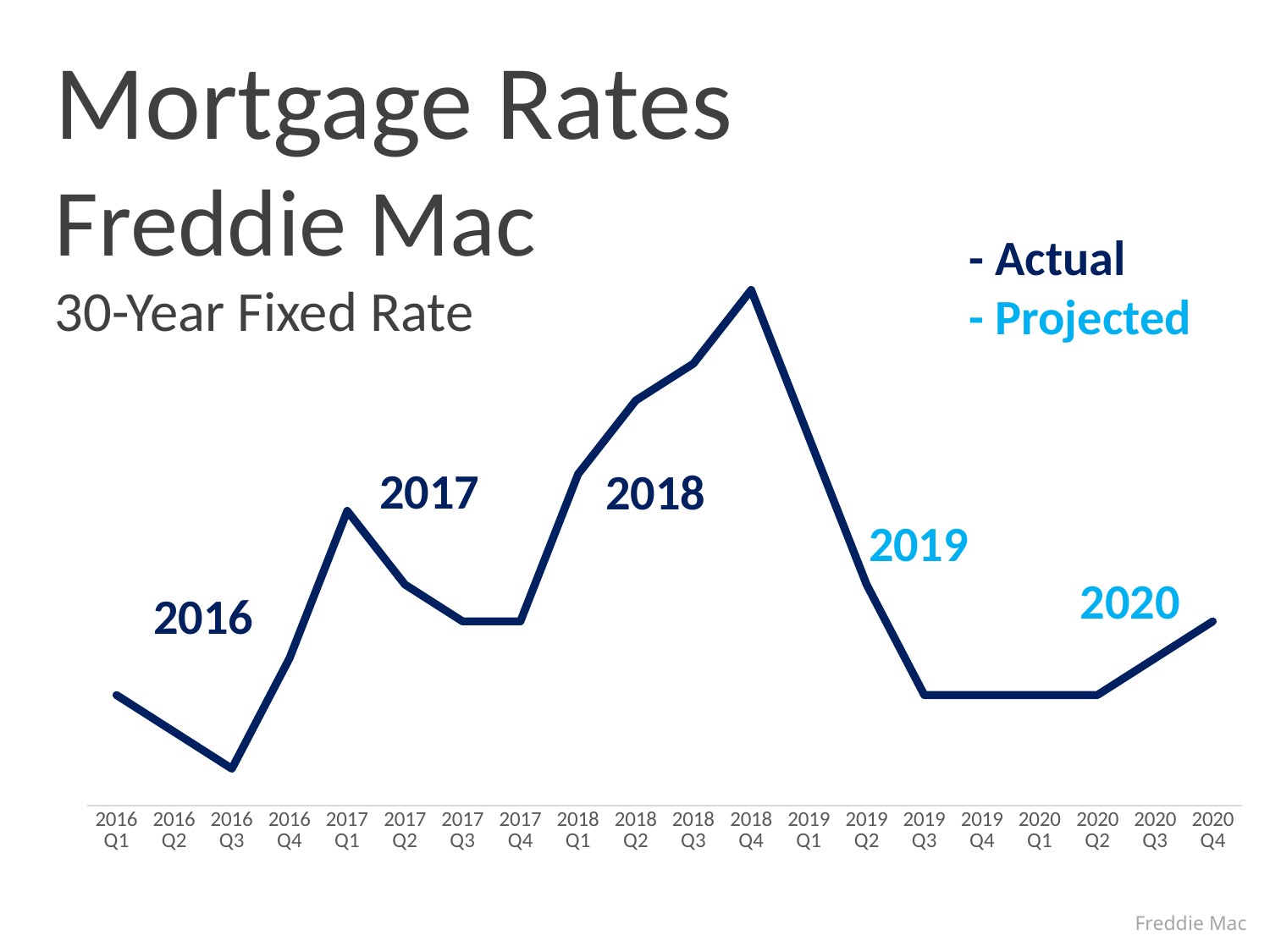
Which is higher, the rate in 2018 Q1 or the rate in 2020 Q4? 2018 Q1 Which years on the chart are labelled in the light blue 'Projected' colour? 2019 and 2020 What kind of chart is shown on the slide? line chart Does the rate rise or fall from 2018 Q1 to 2018 Q4? rise In which quarter does the mortgage rate reach its lowest point? 2016 Q3 Which is higher, the rate in 2016 Q3 or the rate in 2018 Q4? 2018 Q4 Which is higher, the rate in 2017 Q1 or the rate in 2019 Q3? 2017 Q1 How many entries does the legend list? 2 Does the rate rise or fall from 2018 Q4 to 2019 Q3? fall How many quarters are plotted along the x axis? 20 What are the two entries in the chart's legend? Actual and Projected In which quarter does the mortgage rate reach its highest point? 2018 Q4